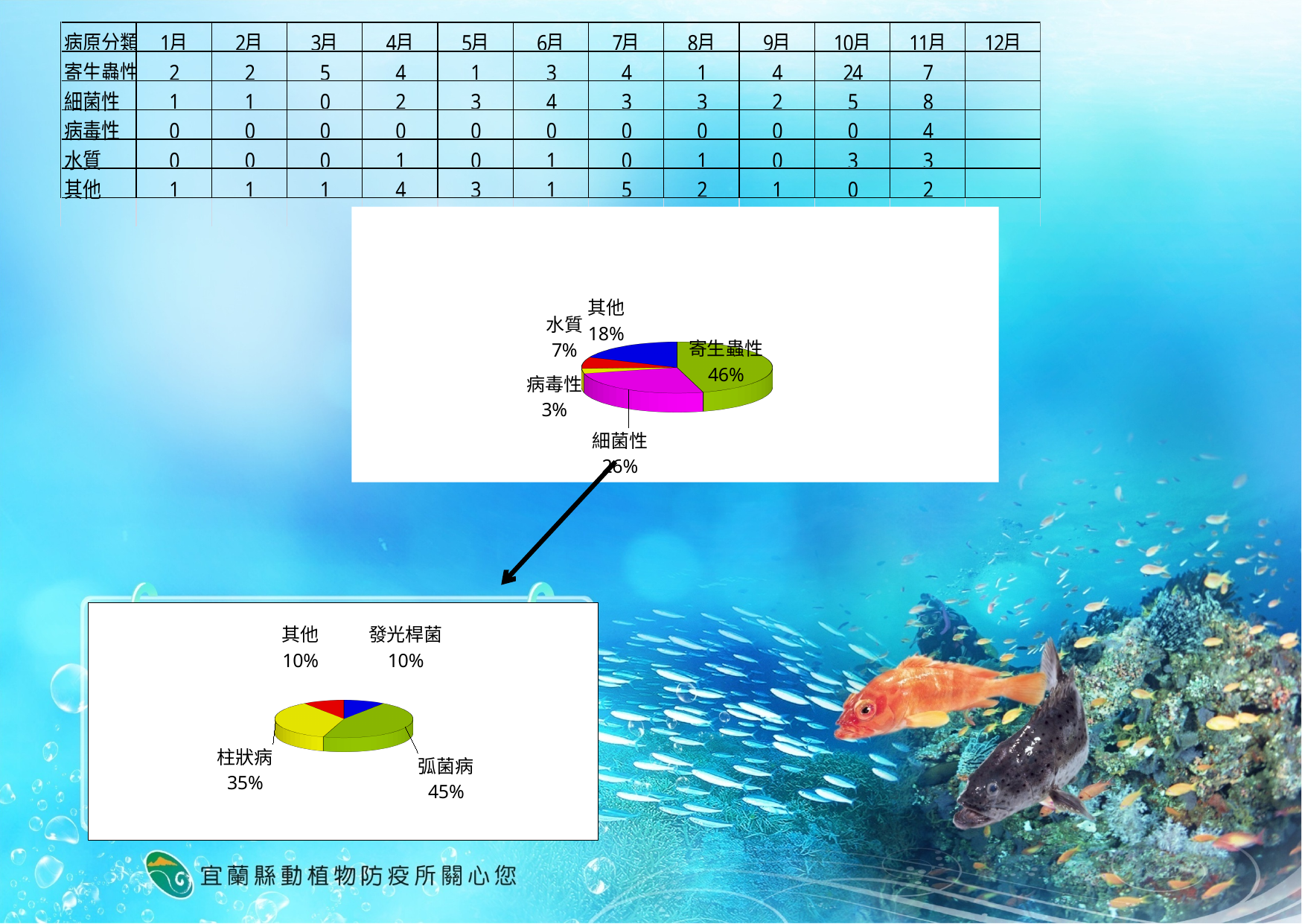
In the lower pie chart, what share does 柱狀病 have? 35% In the upper pie chart, which category has the smallest slice? 病毒性 In the upper pie chart, what share does 寄生蟲性 have? 46% In the lower pie chart, what is the difference between the shares of 弧菌病 and 柱狀病? 10% In the lower pie chart, how many slices are there? 4 In the upper pie chart, what share does 病毒性 have? 3% What kind of chart is the upper chart? Pie chart In the upper pie chart, what share does 水質 have? 7% In the upper pie chart, what share does 其他 have? 18% In the lower pie chart, what share does 弧菌病 have? 45% In the upper pie chart, which category has the largest slice? 寄生蟲性 In the upper pie chart, how many slices are there? 5